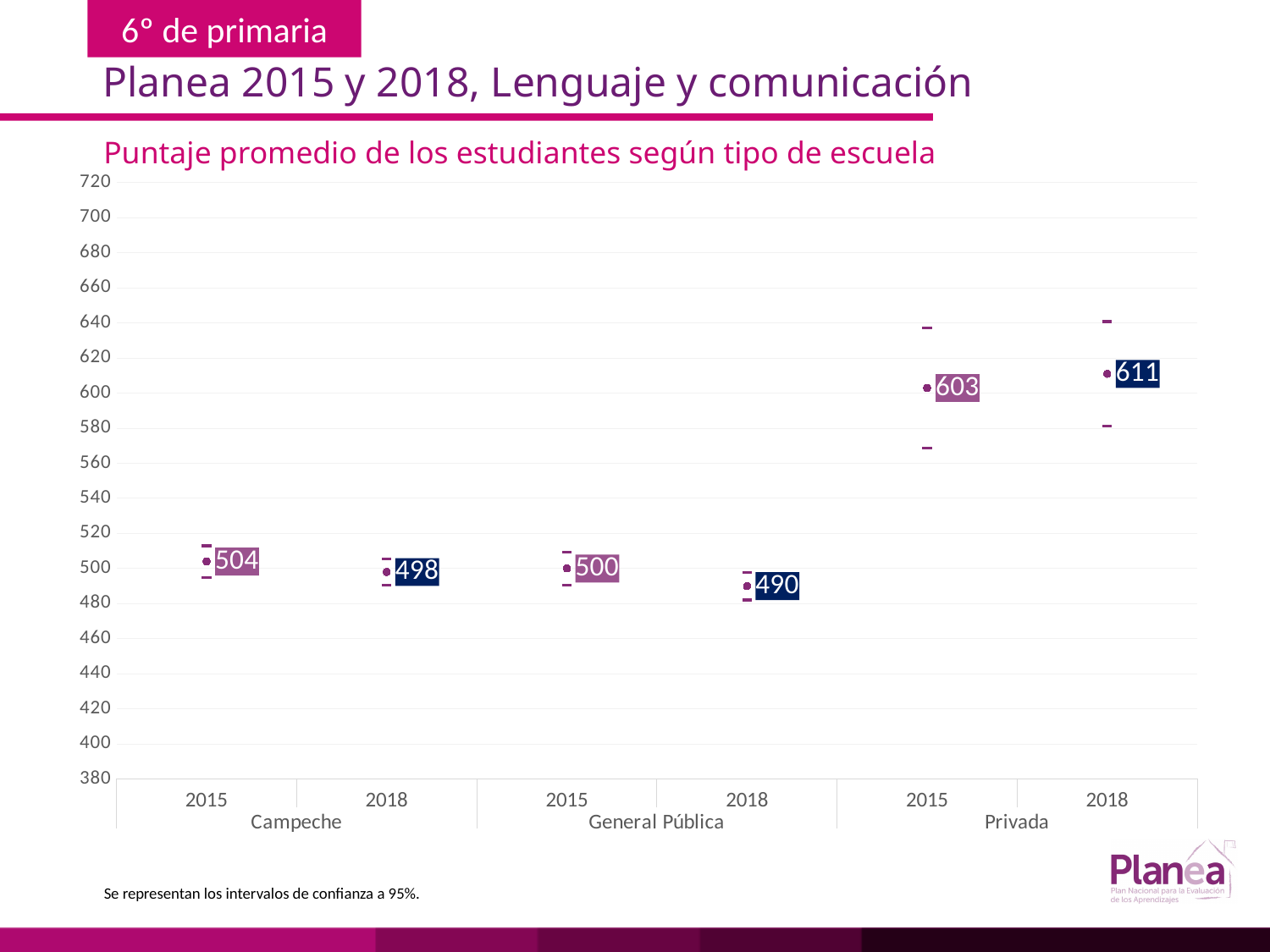
What is the title of the chart? Puntaje promedio de los estudiantes según tipo de escuela What is the average score for Campeche in 2018? 498 What is the average score for Privada in 2015? 603 Which category and year has the lowest average score? General Pública 2018 Which category and year has the highest average score? Privada 2018 What is the average score for Campeche in 2015? 504 What is the difference between the General Pública scores in 2015 and 2018? 10 Which is larger, the Campeche score in 2015 or the General Pública score in 2015? Campeche 2015 What is the average score for General Pública in 2018? 490 What is the difference between the Privada scores in 2018 and 2015? 8 How many data points are plotted on the chart? 6 Did the Campeche average score rise or fall from 2015 to 2018? fall